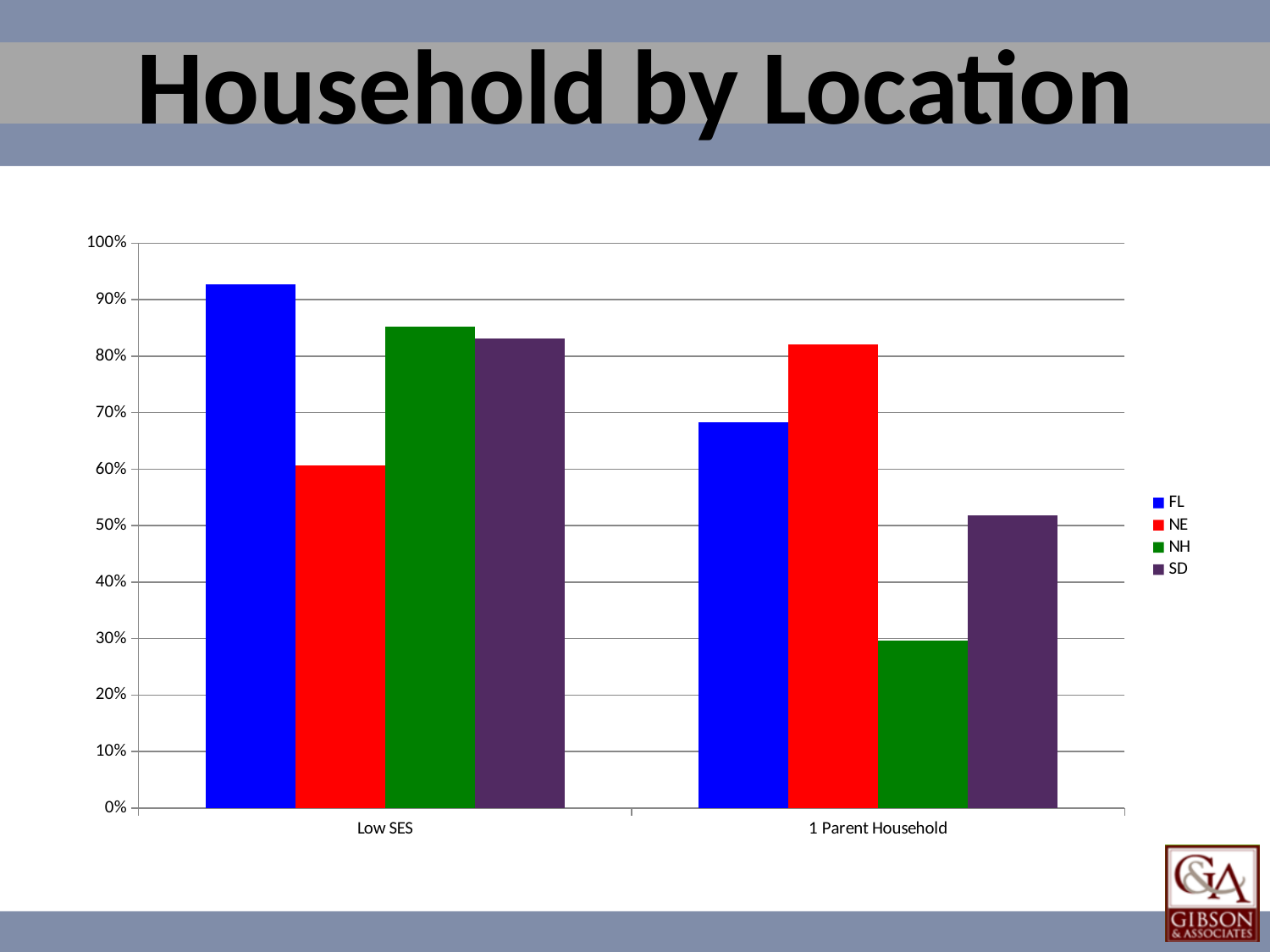
How many categories are shown on the x axis? 2 Which location has the highest value for Low SES? FL What kind of chart is shown on the slide? bar chart What is the title of the slide? Household by Location Which location has the highest value for 1 Parent Household? NE Which location has the lowest value for 1 Parent Household? NH Is the NH value for 1 Parent Household greater or less than 40%? less How many series does the legend list? 4 Which location has the lowest value for Low SES? NE Is the NE value for Low SES greater or less than 70%? less Is the FL value for Low SES greater or less than 90%? greater Which is larger for NE: the Low SES value or the 1 Parent Household value? 1 Parent Household